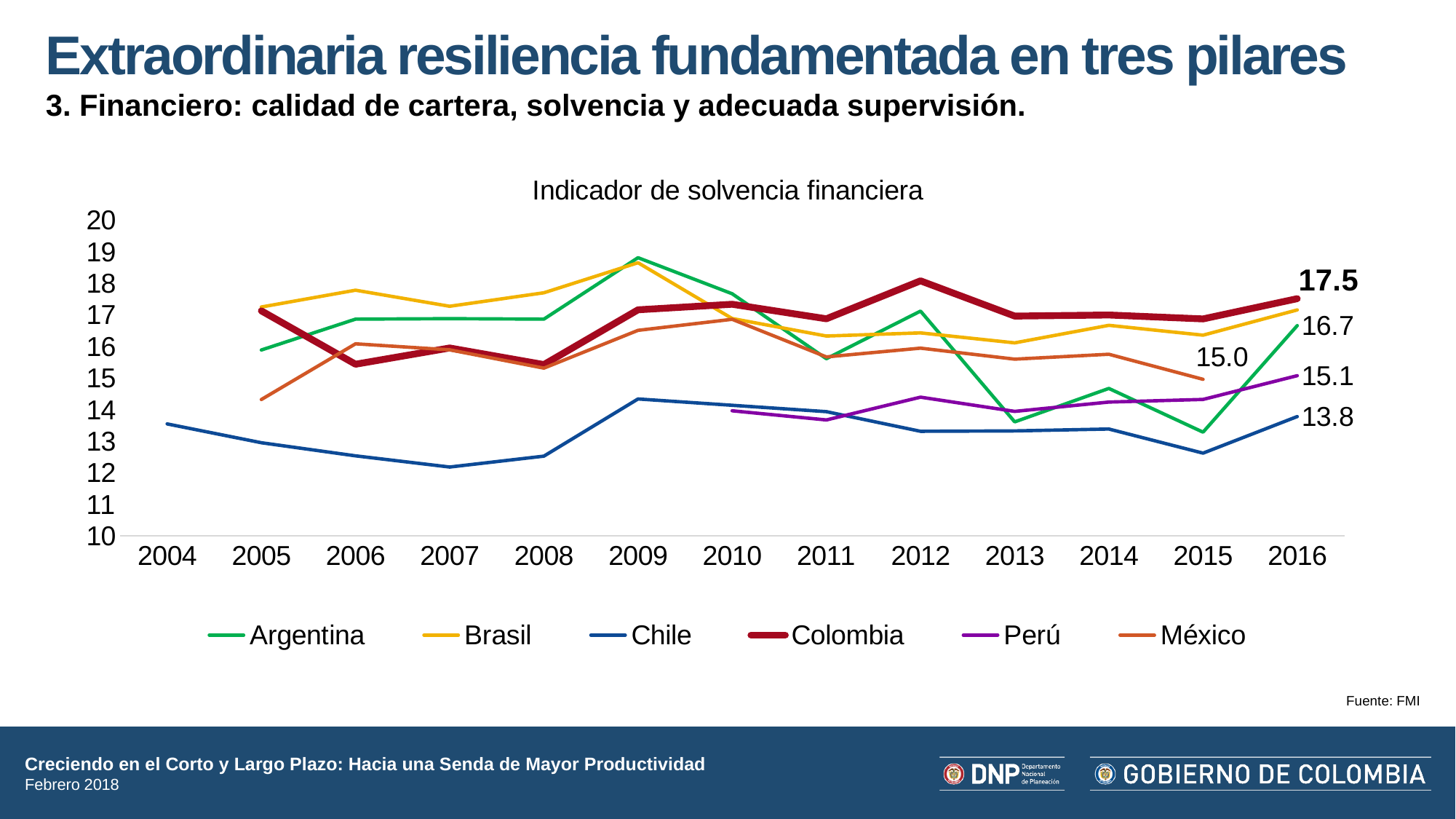
What is the title of the chart? Indicador de solvencia financiera What is the value for Chile in 2016? 13.8 How many years are shown on the x axis of the chart? 13 Which country has the lowest value in 2016? Chile What is the difference between the values for Colombia and Chile in 2016? 3.7 Which is larger in 2016, the value for Colombia or the value for Perú? Colombia What kind of chart is shown on the slide? line chart What is the value for Colombia in 2016? 17.5 What is the value for Perú in 2016? 15.1 What is the value for México in 2015? 15.0 Is the value for Chile in 2007 greater or less than 13? less How many series does the legend of the chart list? 6